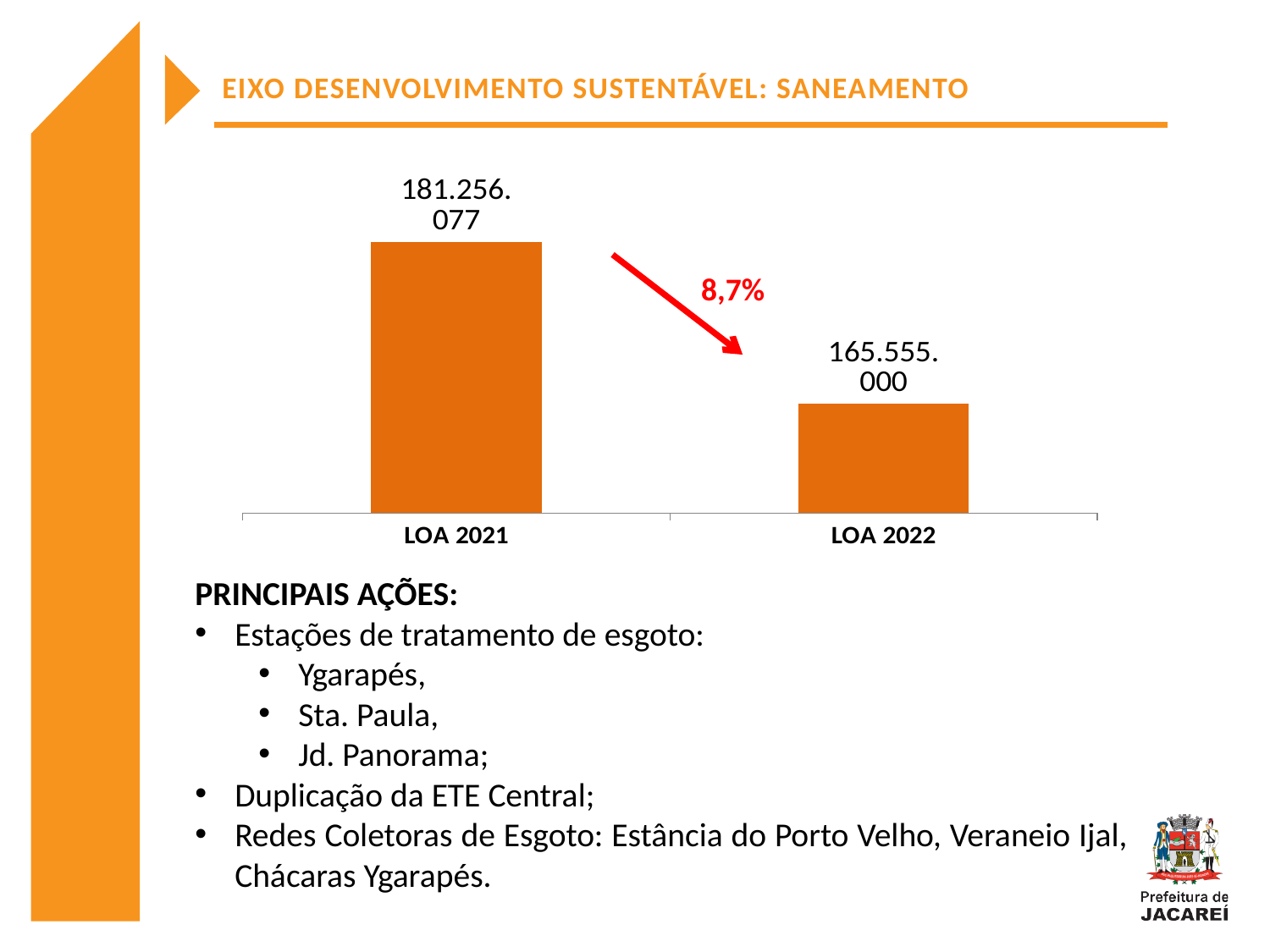
What percentage change is written next to the red arrow on the chart? 8,7% Which category has the lowest value? LOA 2022 How many categories are shown on the x axis of the chart? 2 What is the value for LOA 2022? 165.555.000 What kind of chart is shown on the slide? Bar chart What colour are the bars in the chart? Orange Which category has the highest value? LOA 2021 Which is larger, the value for LOA 2021 or the value for LOA 2022? LOA 2021 What is the value for LOA 2021? 181.256.077 What is the difference between the values for LOA 2021 and LOA 2022? 15.701.077 Do the values rise or fall from LOA 2021 to LOA 2022? Fall